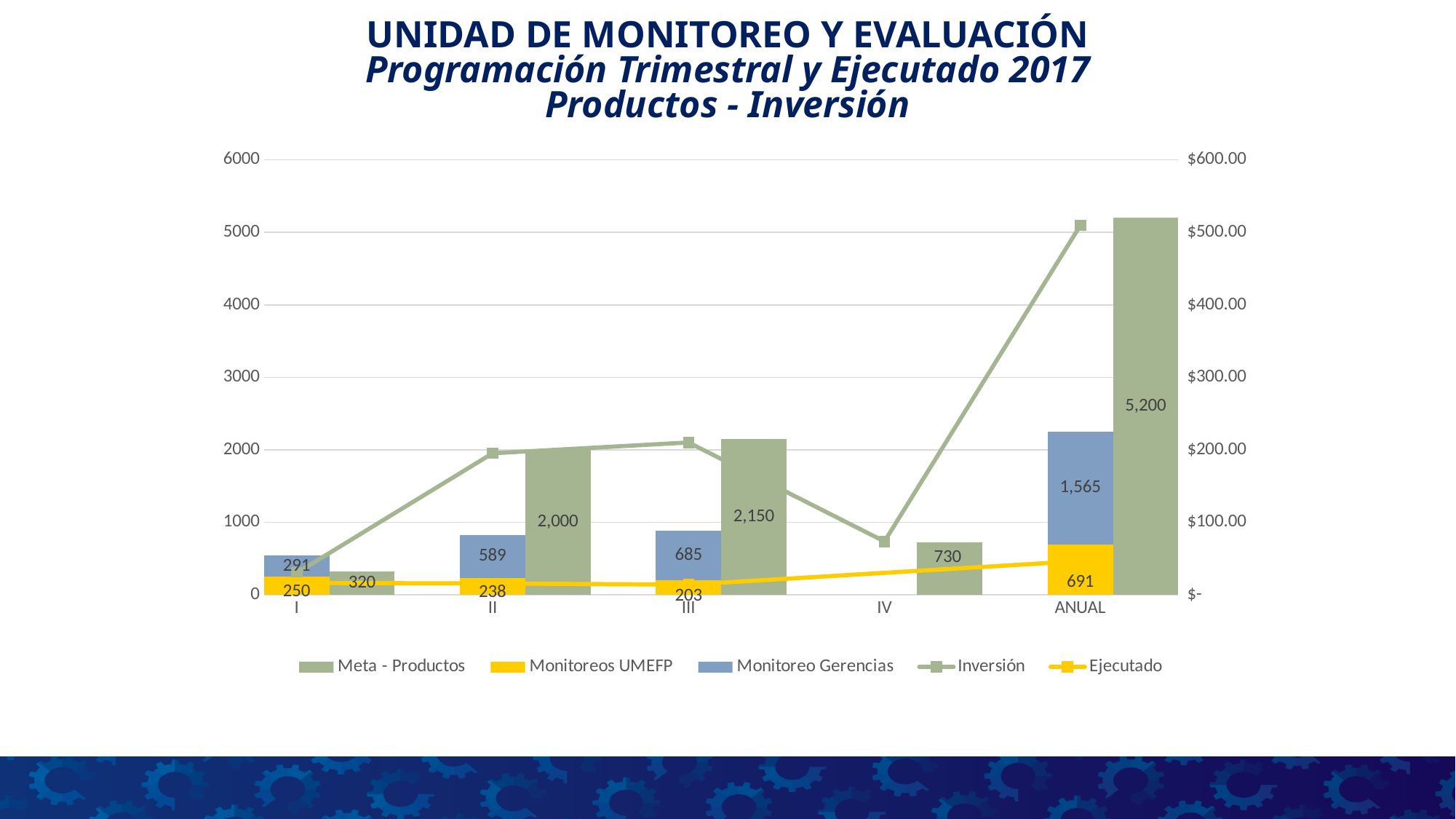
Is the Inversión value for ANUAL greater or less than $400.00? greater Which category has the lowest Meta - Productos value? I How many categories are shown on the x axis? 5 Is the Inversión value for quarter IV greater or less than $100.00? less What is the Meta - Productos value for quarter III? 2,150 What is the Monitoreos UMEFP value for quarter II? 238 Which category has the highest Meta - Productos value? ANUAL How many series does the legend list? 5 What is the difference between the Meta - Productos values for quarter III and quarter II? 150 What is the combined total of Monitoreos UMEFP and Monitoreo Gerencias in the stacked bar for quarter I? 541 Which quarter has the larger Monitoreo Gerencias value, II or III? III What is the Monitoreo Gerencias value for ANUAL? 1,565